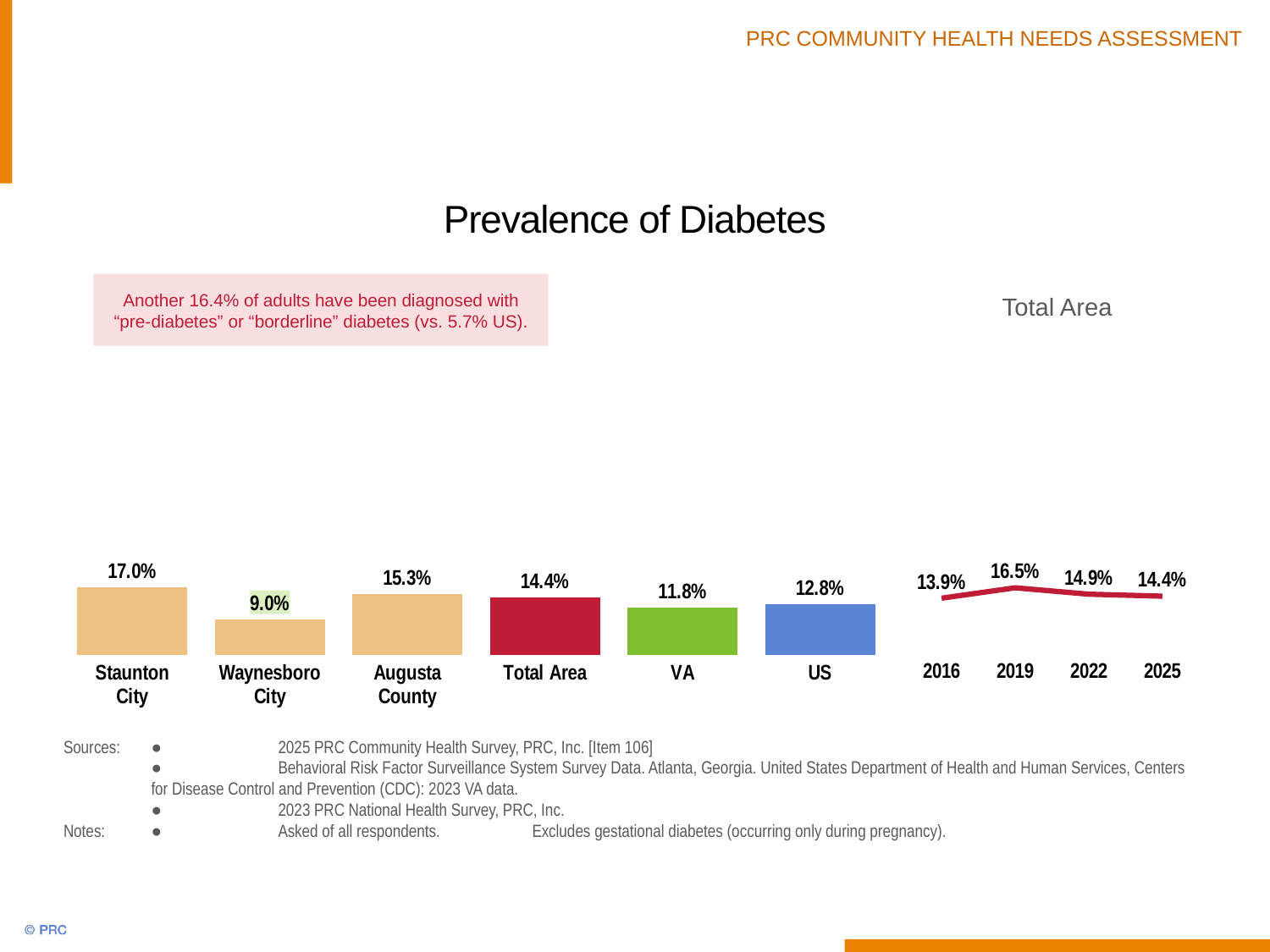
In the bar chart on the left, what is the value for Staunton City? 17.0% In the bar chart on the left, what is the value for Waynesboro City? 9.0% In the bar chart on the left, what is the value for the US? 12.8% In the bar chart on the left, which category has the highest value? Staunton City In the bar chart on the left, what is the difference between Augusta County and VA? 3.5% What kind of chart is the chart on the right titled Total Area? line chart In the bar chart on the left, which is larger, Total Area or US? Total Area In the Total Area line chart on the right, which year has the lowest value? 2016 How many categories are shown in the bar chart on the left? 6 In the bar chart on the left, which category has the lowest value? Waynesboro City In the Total Area line chart on the right, do values rise or fall from 2019 to 2025? fall In the Total Area line chart on the right, what is the value for 2019? 16.5%